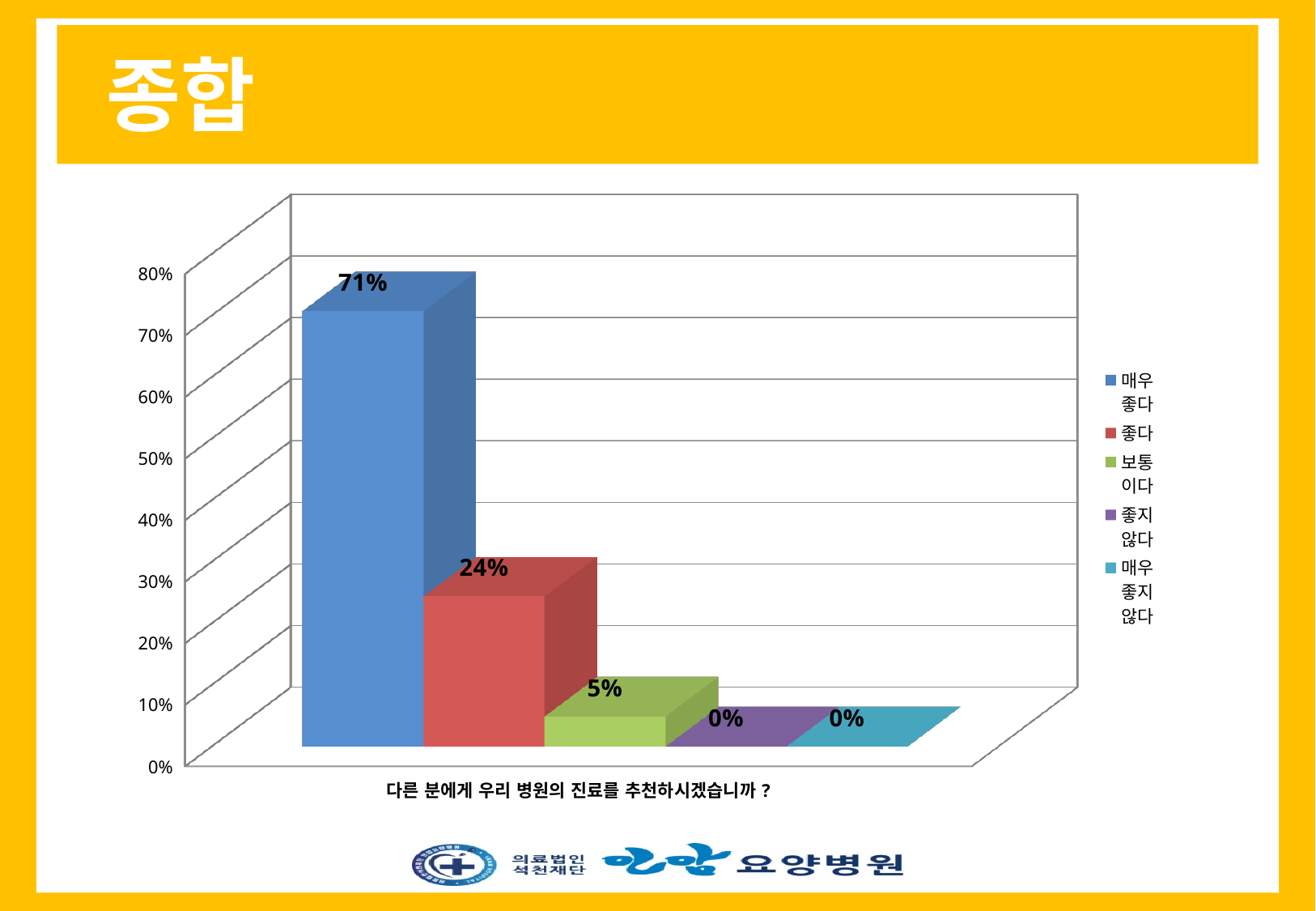
What is the title of the slide? 종합 What value is shown for 좋지 않다? 0% What kind of chart is shown on the slide? bar chart What is the difference between the values for 매우 좋다 and 좋다? 47% What value is shown for 매우 좋다? 71% Which is larger, the value for 좋다 or the value for 보통이다? 좋다 What value is shown for 보통이다? 5% What value is shown for 좋다? 24% Which response has the highest value? 매우 좋다 How many series does the legend list? 5 Is the value for 매우 좋다 greater or less than 60%? greater What is the difference between the values for 좋다 and 보통이다? 19%